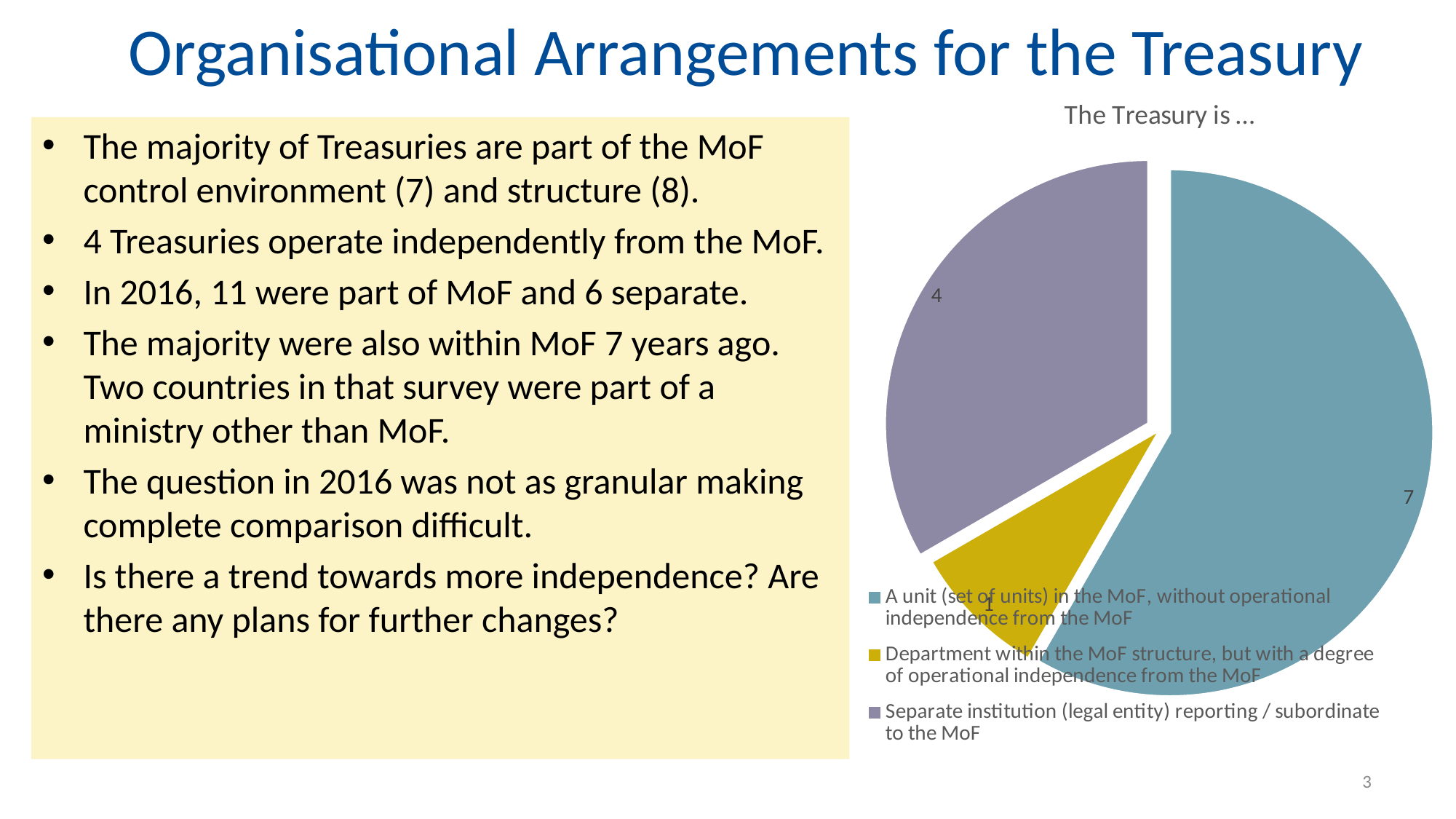
What is the value for 'A unit (set of units) in the MoF, without operational independence from the MoF'? 7 What is the value for 'Separate institution (legal entity) reporting / subordinate to the MoF'? 4 What is the title of the pie chart? The Treasury is … How many entries does the legend of the pie chart list? 3 What kind of chart is shown on the slide? pie chart What is the total of all the values shown in the pie chart? 12 Which is larger: the value for 'Separate institution (legal entity) reporting / subordinate to the MoF' or the value for 'Department within the MoF structure, but with a degree of operational independence from the MoF'? Separate institution (legal entity) reporting / subordinate to the MoF What is the value for 'Department within the MoF structure, but with a degree of operational independence from the MoF'? 1 Which category has the smallest slice in the pie chart? Department within the MoF structure, but with a degree of operational independence from the MoF How many slices does the pie chart have? 3 Which category has the largest slice in the pie chart? A unit (set of units) in the MoF, without operational independence from the MoF What is the difference between the value for 'A unit (set of units) in the MoF, without operational independence from the MoF' and the value for 'Separate institution (legal entity) reporting / subordinate to the MoF'? 3